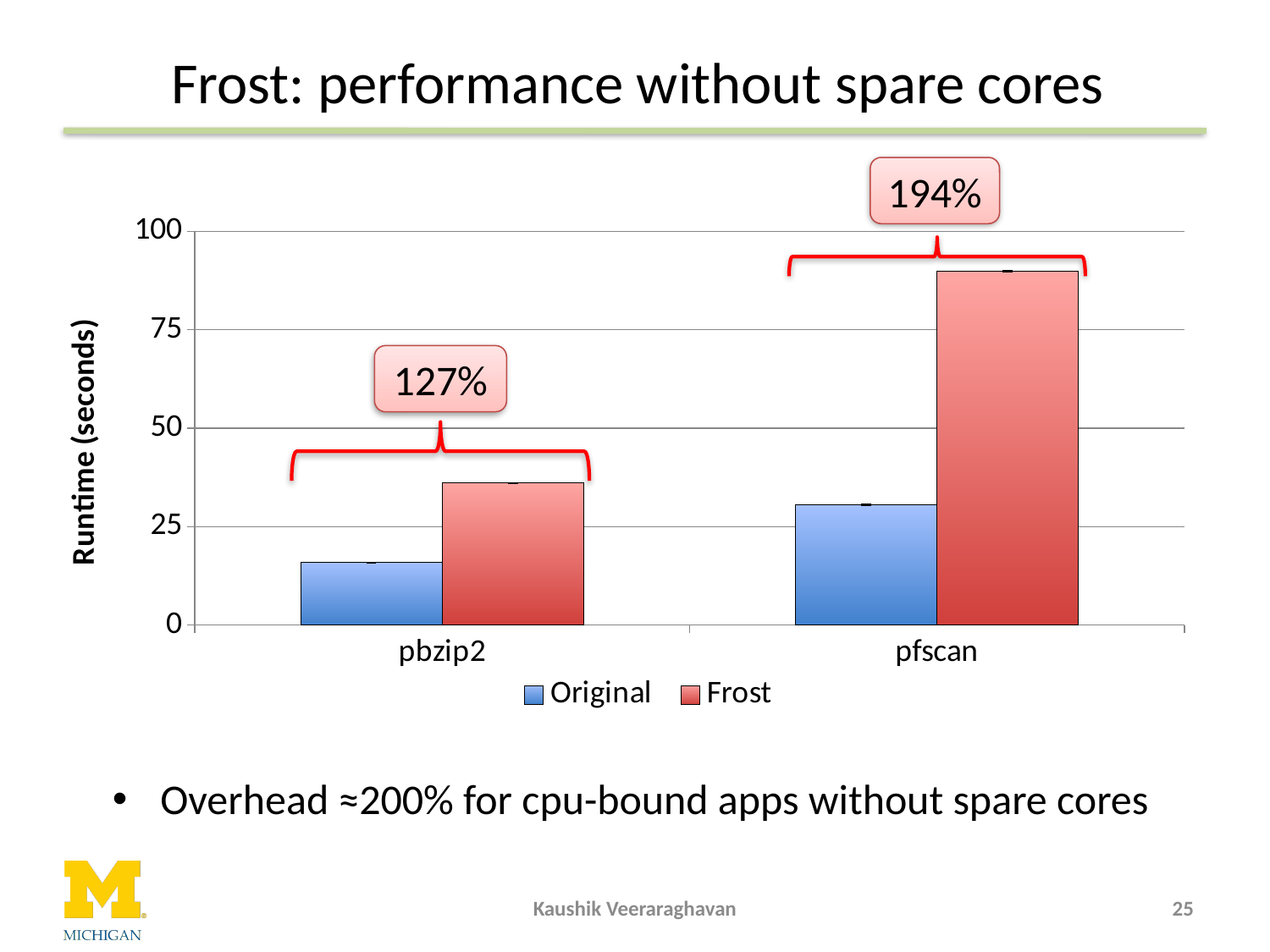
Which category has the lowest Original runtime? pbzip2 How many categories are shown on the x axis of the chart? 2 What is the label of the chart's y axis? Runtime (seconds) Is the Original runtime for pbzip2 greater or less than 25? less Is the Original runtime for pfscan greater or less than 50? less For pbzip2, which series has the larger runtime, Original or Frost? Frost Which series are listed in the chart's legend? Original and Frost Is the Frost runtime for pbzip2 greater or less than 50? less How many series does the chart's legend list? 2 Which category has the highest Frost runtime? pfscan What kind of chart is shown on the slide? bar chart